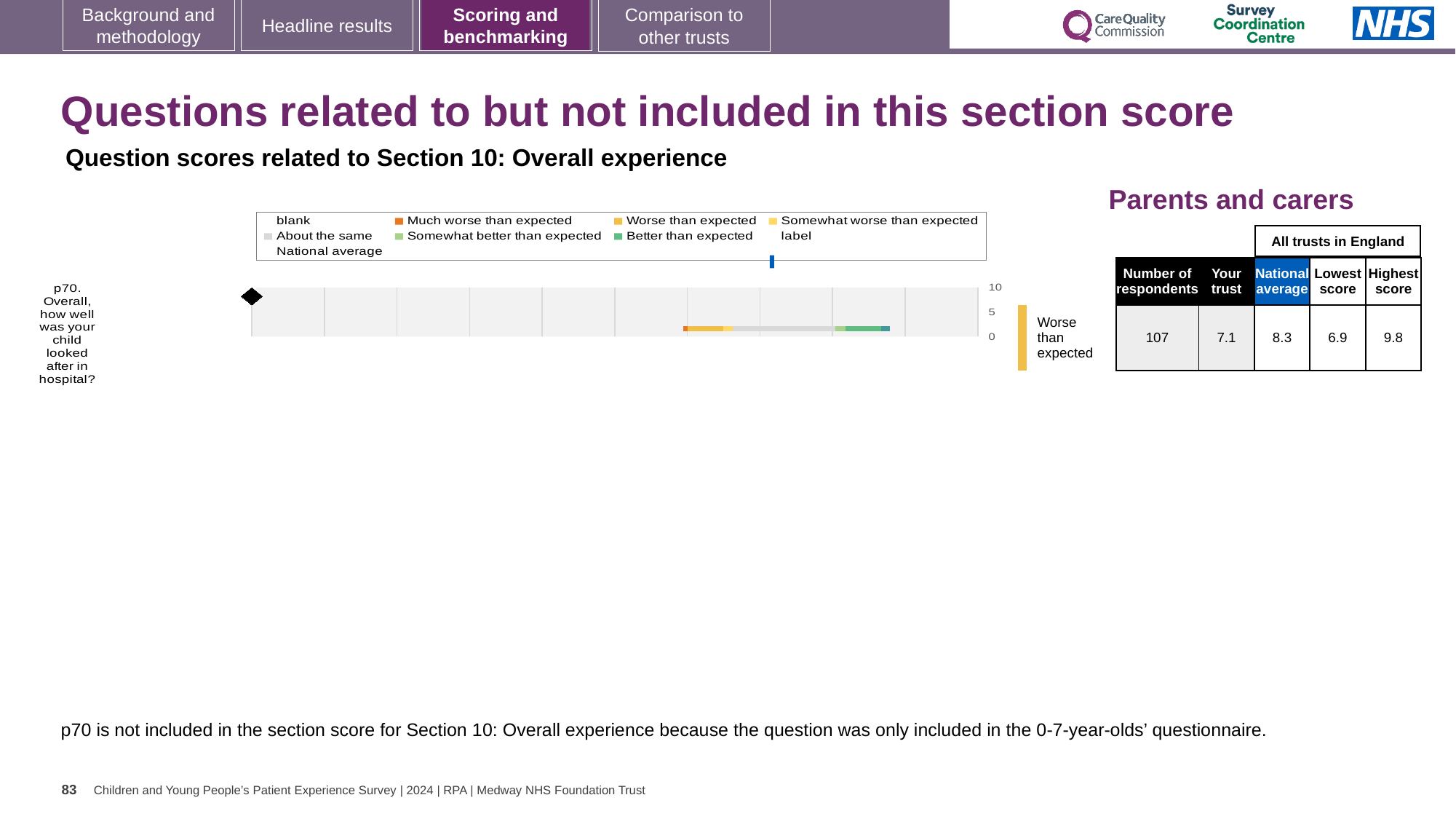
In the Parents and carers table, what is the highest score among all trusts in England for p70? 9.8 Which question is plotted in the chart? p70. Overall, how well was your child looked after in hospital? What rating label is shown to the right of the chart for p70? Worse than expected What kind of chart is used to show the p70 question score? bar chart How many respondents answered p70 according to the Parents and carers table? 107 In the Parents and carers table, what is the national average score for p70? 8.3 For p70, what is the difference between the highest score and the lowest score among all trusts in England? 2.9 In the Parents and carers table, what is the lowest score among all trusts in England for p70? 6.9 For p70, what is the difference between the national average and the 'Your trust' score? 1.2 How many survey questions are plotted in the chart? 1 For p70, which is higher: the 'Your trust' score or the national average? National average In the Parents and carers table, what is the 'Your trust' score for p70? 7.1